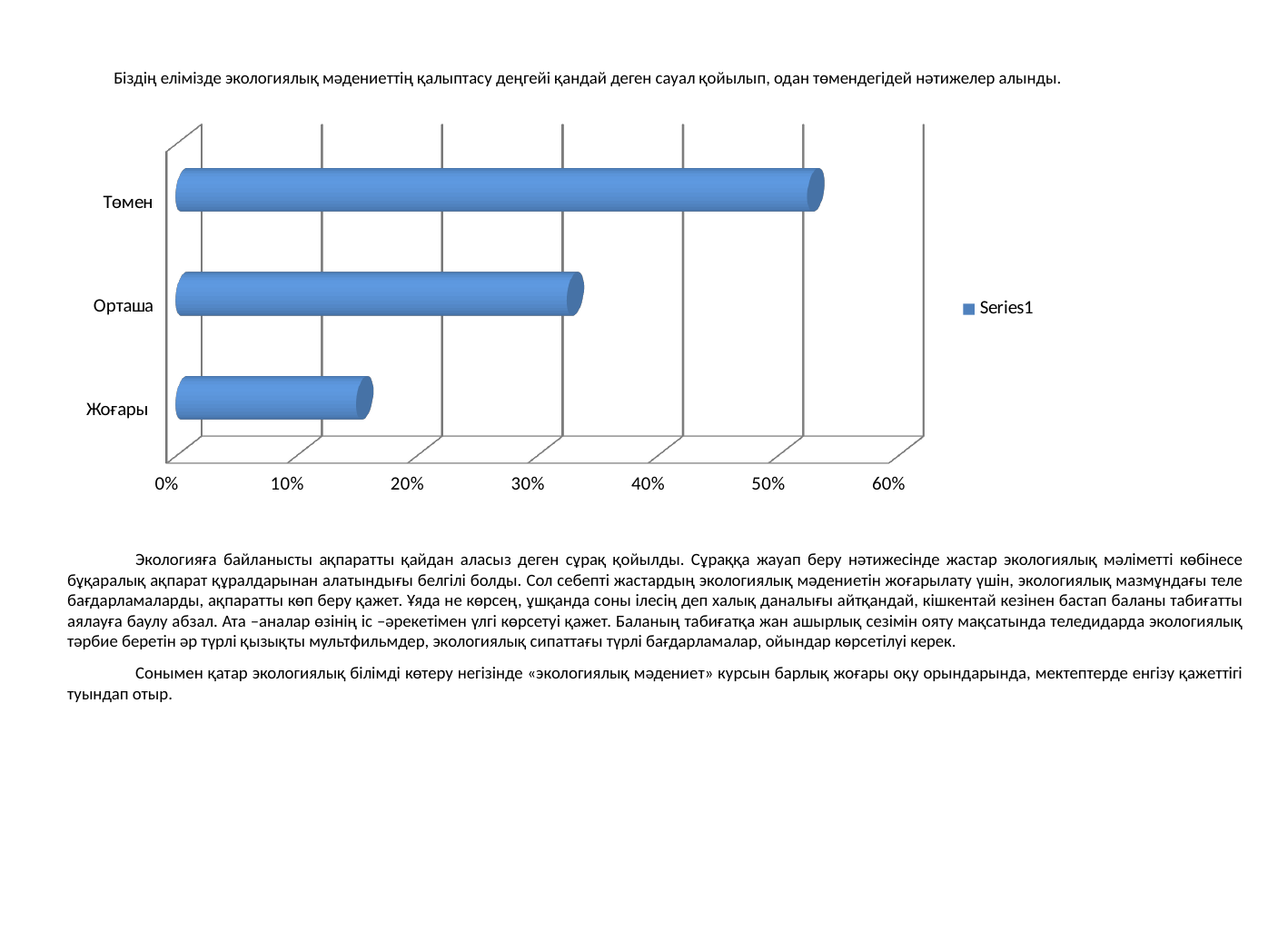
Is the value for Төмен greater or less than 50%? greater Is the value for Орташа greater or less than 30%? greater Which category has the lowest value in the chart? Жоғары Which is larger, the value for Орташа or the value for Жоғары? Орташа What is the name of the series shown in the legend? Series1 Is the value for Орташа greater or less than 40%? less Which category has the highest value in the chart? Төмен How many series does the legend list? 1 Which is larger, the value for Төмен or the value for Орташа? Төмен How many categories are shown in the chart? 3 What kind of chart is shown on the slide? bar chart